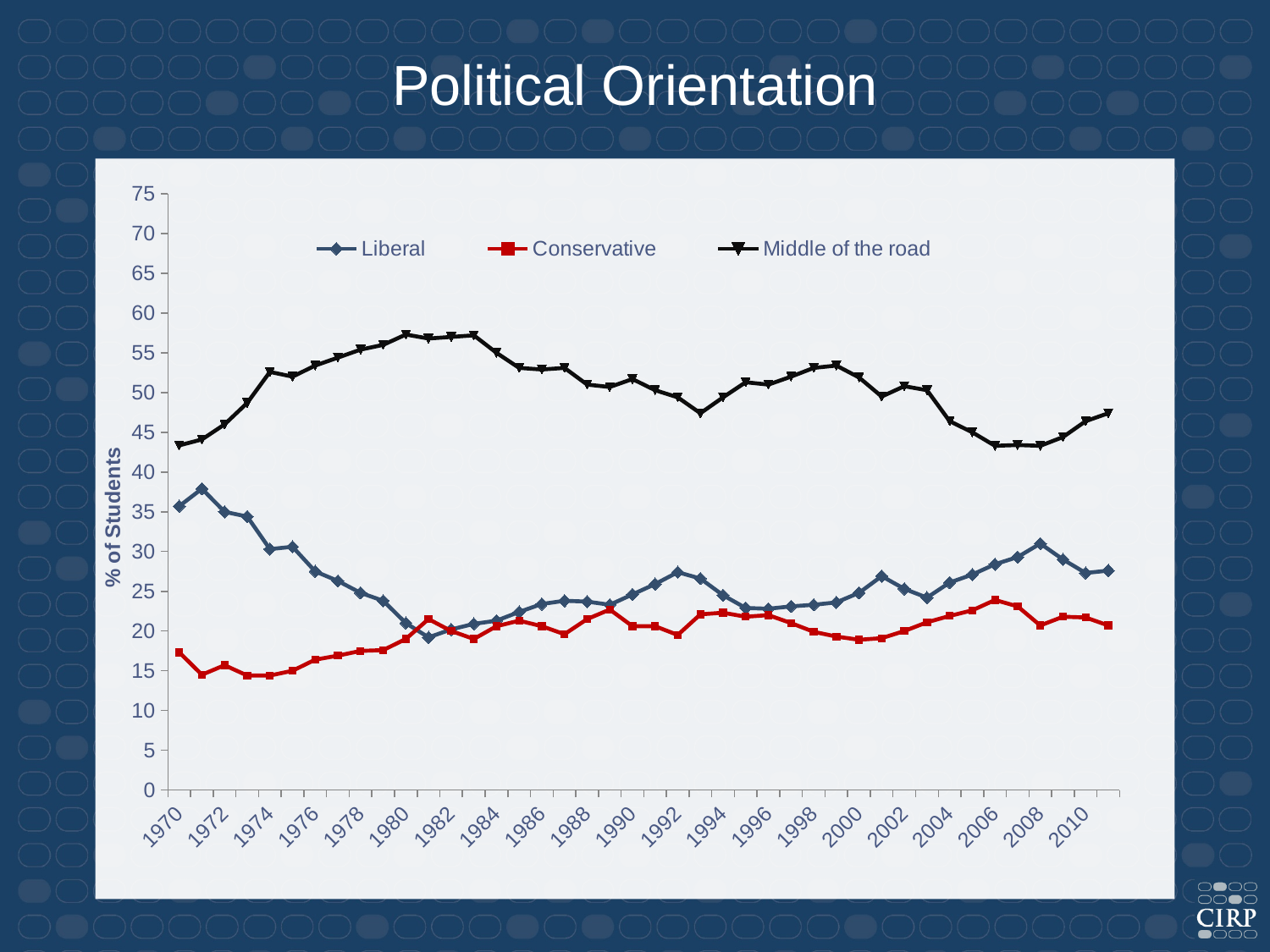
How many series does the legend list? 3 Is the value for Conservative in 1973 greater or less than 20? less Which series has the highest value in 1990? Middle of the road What is the title of the chart? Political Orientation What kind of chart is shown on the slide? line chart Does the Liberal series rise or fall from 1970 to 1980? fall Is the value for Middle of the road in 1970 greater or less than 50? less Is the value for Middle of the road in 1980 greater or less than 55? greater Which series has the lowest value in 1975? Conservative What is the label on the y axis? % of Students In 1970, which is larger, the value for Liberal or the value for Conservative? Liberal